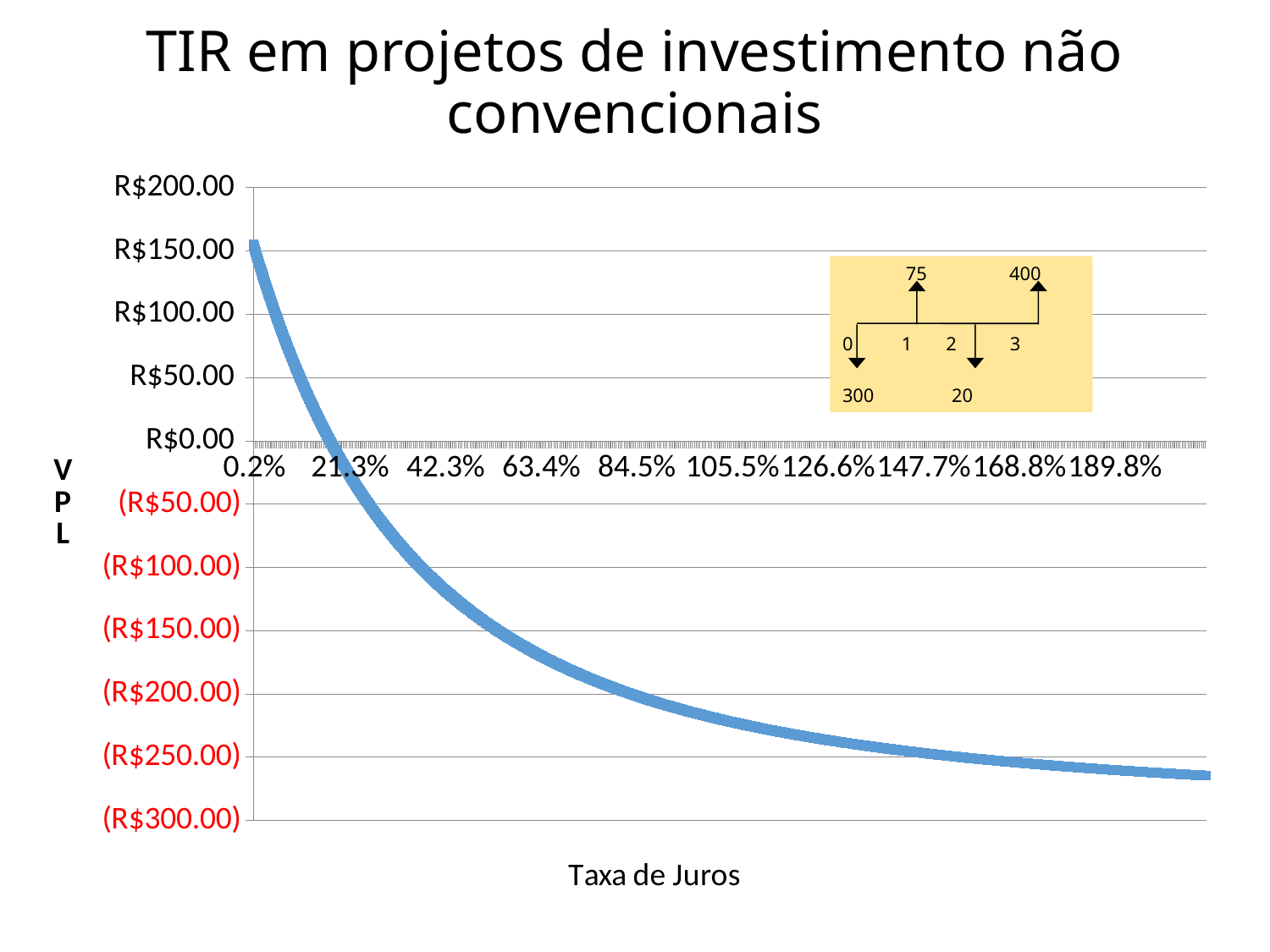
Does the VPL value rise or fall as the Taxa de Juros increases along the x axis? fall What kind of chart is shown on the slide? line chart Is the VPL value at 105.5% greater or less than (R$200.00)? less Is the VPL value at 21.3% greater or less than R$0.00? less Is the VPL value at 0.2% greater or less than R$100.00? greater Which x-axis tick has the higher VPL value, 0.2% or 189.8%? 0.2% What is the label of the x axis of the chart? Taxa de Juros How many tick labels are shown on the x axis of the chart? 10 What is the title of the slide containing the chart? TIR em projetos de investimento não convencionais